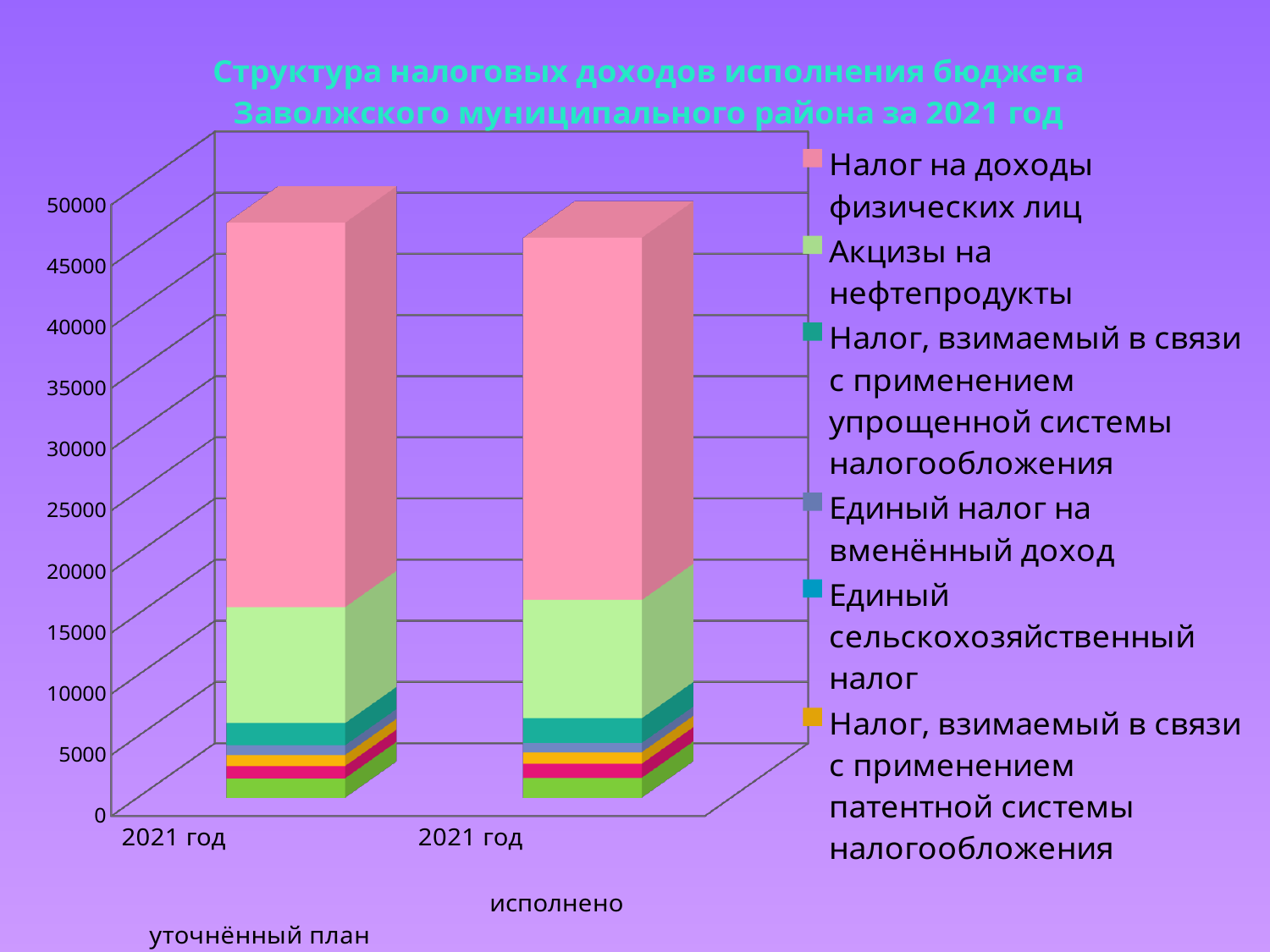
Is the value of Акцизы на нефтепродукты in the 2021 год уточнённый план bar greater or less than 5000? greater Is the total of the bar for 2021 год исполнено greater or less than 50000? less What is the title of the chart? Структура налоговых доходов исполнения бюджета Заволжского муниципального района за 2021 год Is the total of the bar for 2021 год исполнено greater or less than 40000? greater Which series makes up the largest part of each stacked bar? Налог на доходы физических лиц How many bars are plotted in the chart? 2 What kind of chart is shown on the slide? Stacked bar chart How many series does the legend list? 6 Which series is listed first in the legend? Налог на доходы физических лиц Which bar is taller: 2021 год уточнённый план or 2021 год исполнено? 2021 год уточнённый план